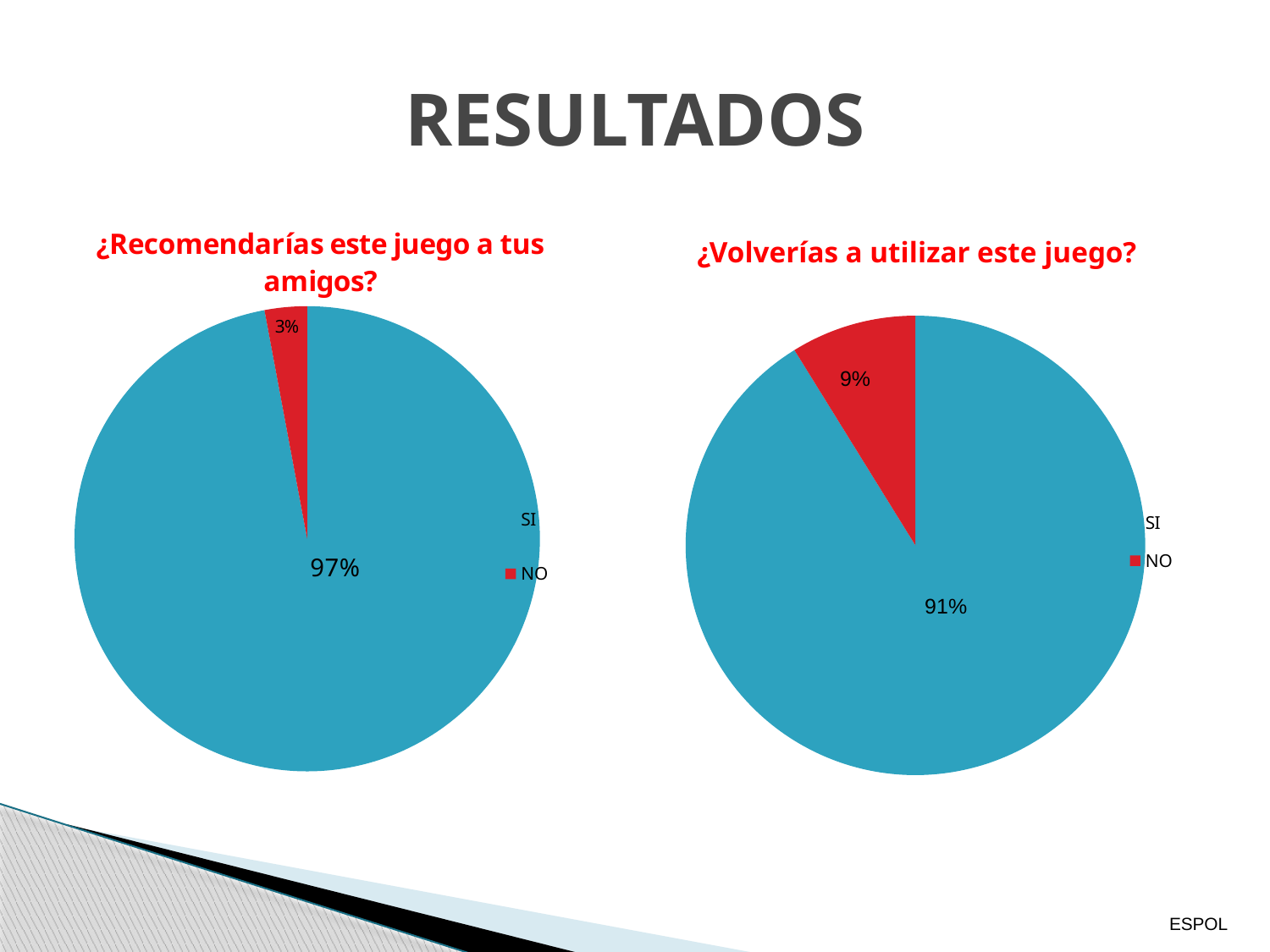
How many categories does the chart titled '¿Recomendarías este juego a tus amigos?' show? 2 What type of chart is used for '¿Volverías a utilizar este juego?'? Pie chart In the chart titled '¿Recomendarías este juego a tus amigos?', what is the difference between the SI and NO percentages? 94% In the chart titled '¿Volverías a utilizar este juego?', what percentage is shown for NO? 9% In the chart titled '¿Volverías a utilizar este juego?', what is the difference between the SI and NO percentages? 82% In the chart titled '¿Recomendarías este juego a tus amigos?', which category has the largest slice? SI In the chart titled '¿Volverías a utilizar este juego?', what percentage is shown for SI? 91% In the chart titled '¿Recomendarías este juego a tus amigos?', what percentage is shown for NO? 3% In the chart titled '¿Volverías a utilizar este juego?', what colour is the NO slice? Red Is the NO share larger in the left chart ('¿Recomendarías este juego a tus amigos?') or the right chart ('¿Volverías a utilizar este juego?')? The right chart In the chart titled '¿Recomendarías este juego a tus amigos?', what percentage is shown for SI? 97% In the chart titled '¿Volverías a utilizar este juego?', which category has the smallest slice? NO